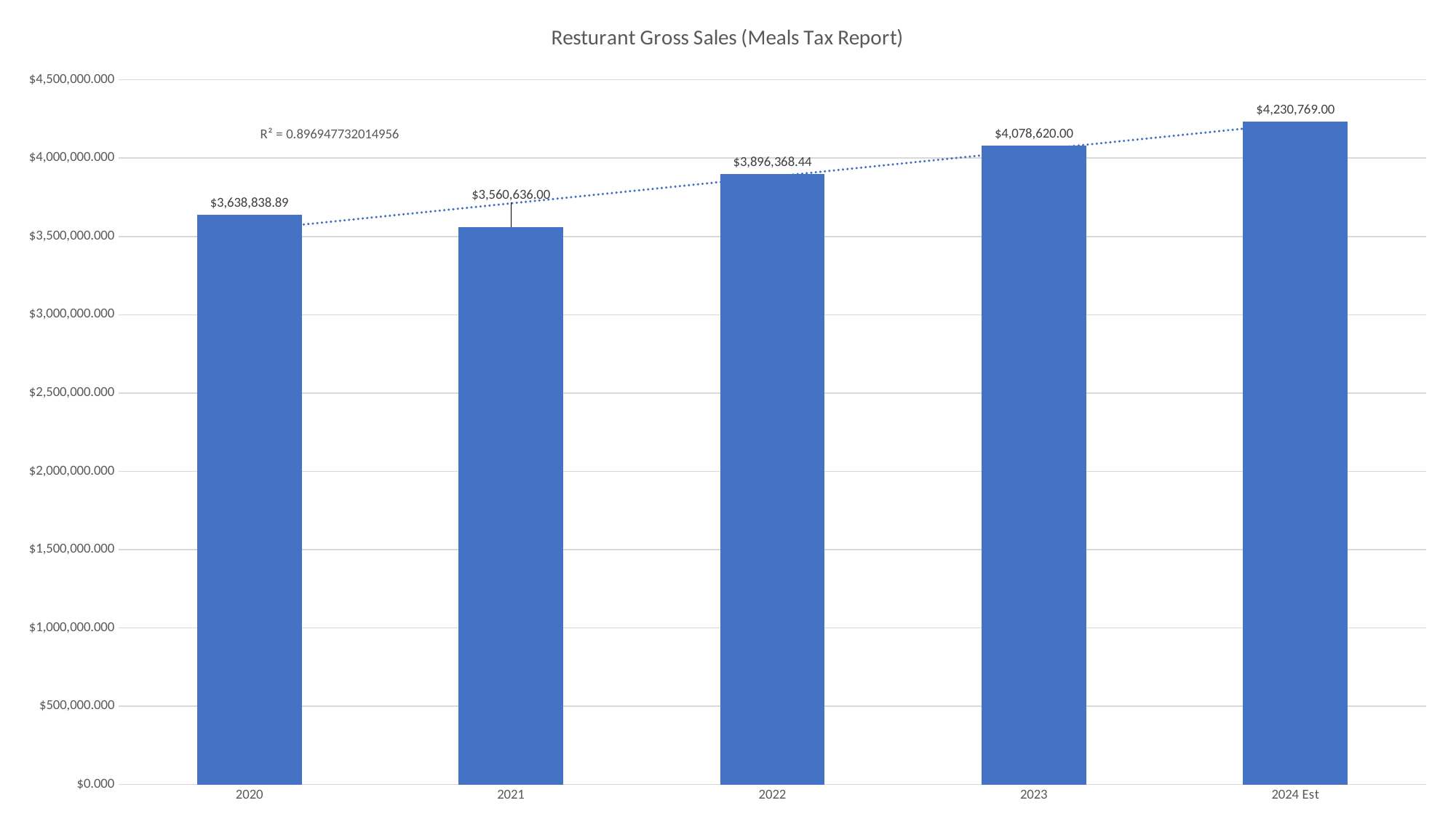
What is the title of the chart? Resturant Gross Sales (Meals Tax Report) Which is larger, the gross sales for 2020 or for 2021? 2020 What type of chart is shown on the slide? Bar chart What is the gross sales value for 2024 Est? $4,230,769.00 What is the gross sales value for 2020? $3,638,838.89 How many years (categories) are plotted on the x axis? 5 Is the value for 2023 greater or less than $4,000,000.000? greater What is the gross sales value for 2022? $3,896,368.44 Which year has the lowest gross sales? 2021 Which year has the highest gross sales? 2024 Est What R² value is shown for the trendline? 0.896947732014956 What is the difference between the gross sales for 2023 and 2022? $182,251.56